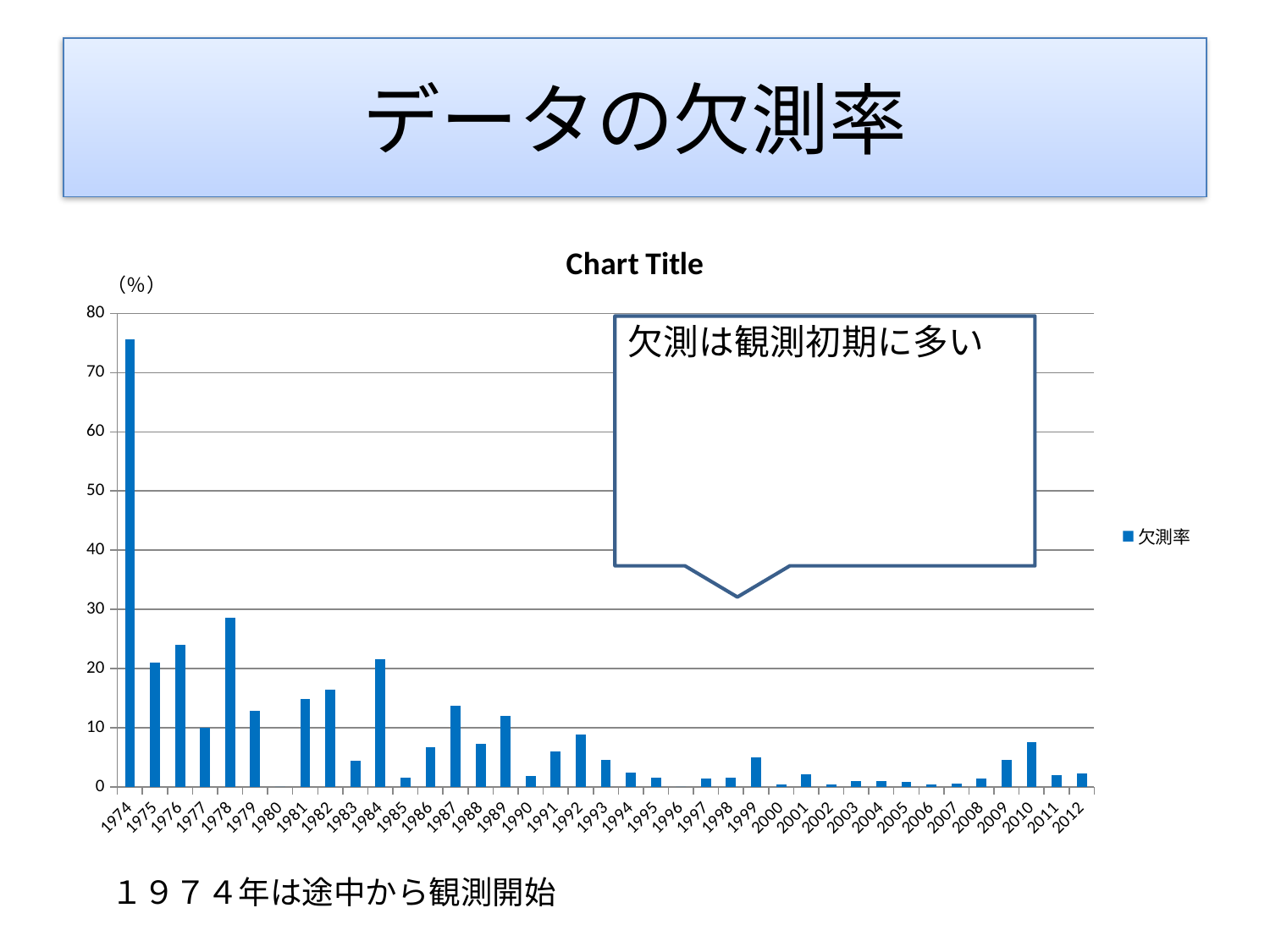
What is the name of the series shown in the chart legend? 欠測率 What kind of chart is shown on the slide? bar chart Which year has the highest missing-data rate (欠測率) in the chart? 1974 Is the value for 2010 greater or less than 10? less How many years are shown on the x axis of the chart? 39 How many series does the chart legend list? 1 Is the value for 1978 greater or less than 30? less Is the value for 1976 greater or less than 20? greater Overall, do the values rise or fall from 1974 to 2012? fall Which is larger, the value for 1984 or the value for 1987? 1984 Which is larger, the value for 1978 or the value for 1975? 1978